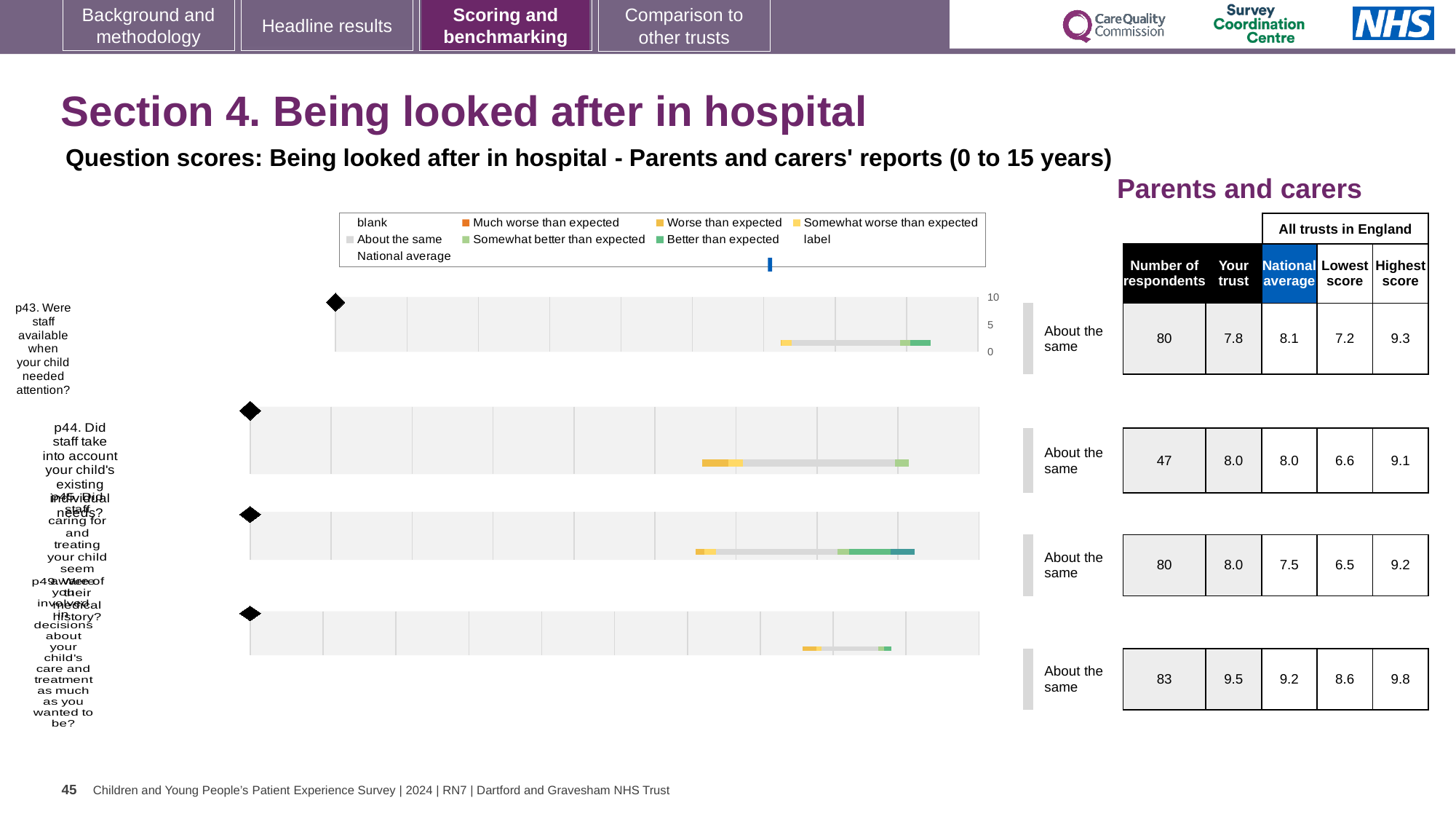
What is the 'Your trust' score for p43 (Were staff available when your child needed attention?)? 7.8 What is the highest score across all trusts in England for p49? 9.8 For p45, how much higher is the 'Your trust' score than the national average? 0.5 How many respondents are shown for p43? 80 How many questions are plotted on the slide? 4 What is the 'Your trust' score for p49? 9.5 What is the national average score for p44 (Did staff take into account your child's existing individual needs?)? 8.0 Which question has the lowest national average score? p45 What is the lowest score across all trusts in England for p44? 6.6 Which question has the highest 'Your trust' score? p49 For p43, which is larger: the 'Your trust' score or the national average? National average What benchmark category is shown for every question on the slide? About the same